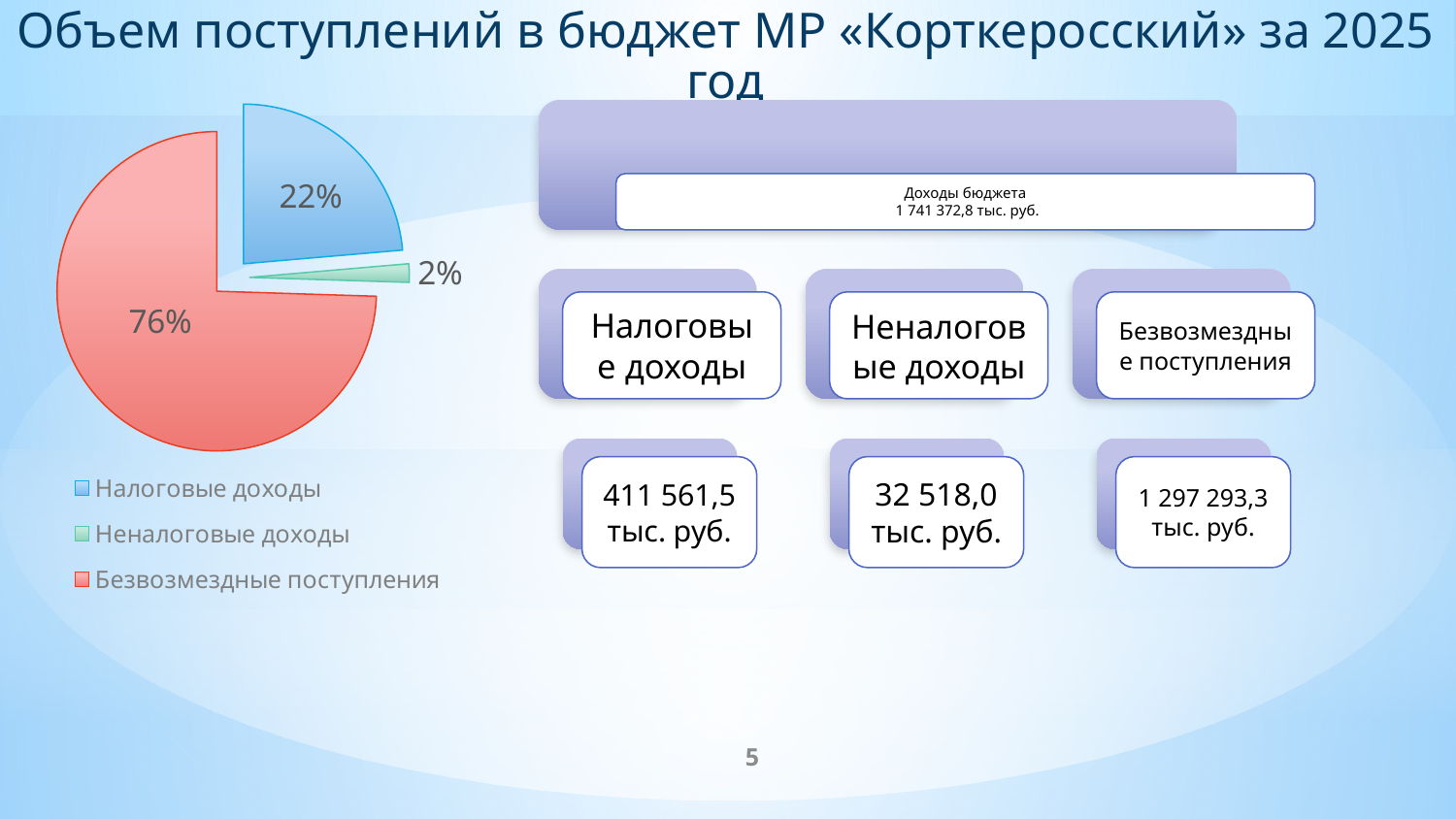
What type of chart is shown on the slide? Pie chart What colour is the slice for Безвозмездные поступления? Red What colour is the slice for Налоговые доходы? Blue Which category has the smallest slice of the pie? Неналоговые доходы What share of the pie does Налоговые доходы represent? 22% What is the difference in percentage points between Безвозмездные поступления and Налоговые доходы? 54 What share of the pie does Безвозмездные поступления represent? 76% Which is larger: the share for Налоговые доходы or the share for Неналоговые доходы? Налоговые доходы How many entries does the legend list? 3 Which category has the largest slice of the pie? Безвозмездные поступления What share of the pie does Неналоговые доходы represent? 2% How many slices does the pie chart have? 3